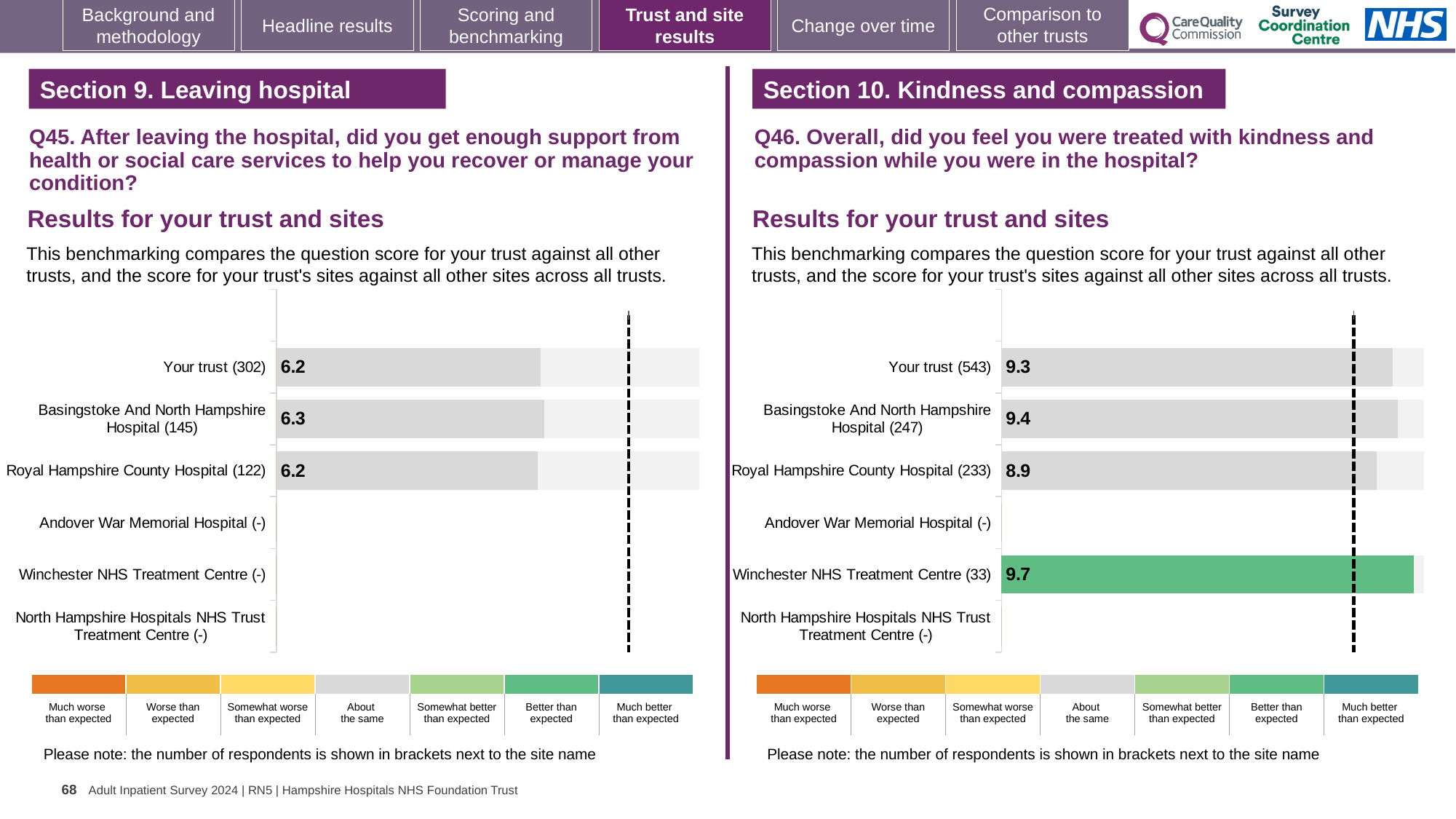
On the Q46 chart (right), what is the difference between the scores for Winchester NHS Treatment Centre (33) and Royal Hampshire County Hospital (233)? 0.8 On the Q46 chart (right), which site's bar is coloured green, indicating 'Better than expected'? Winchester NHS Treatment Centre (33) On the Q45 chart (left), what is the score for Basingstoke And North Hampshire Hospital (145)? 6.3 On the Q46 chart (right), which site has the lowest score among those with a score shown? Royal Hampshire County Hospital (233) On the Q46 chart (right), what is the score for Winchester NHS Treatment Centre (33)? 9.7 On the Q45 chart (left), how many sites have a score shown? 3 What kind of chart is used on the Q46 chart (right)? Bar chart On the Q46 chart (right), which is larger: the score for Basingstoke And North Hampshire Hospital (247) or the score for Your trust (543)? Basingstoke And North Hampshire Hospital (247) On the Q45 chart (left), what is the score for Your trust (302)? 6.2 On the Q46 chart (right), what is the score for Royal Hampshire County Hospital (233)? 8.9 On the Q46 chart (right), which site has the highest score? Winchester NHS Treatment Centre (33) On the Q45 chart (left), what is the difference between the scores for Basingstoke And North Hampshire Hospital (145) and Your trust (302)? 0.1